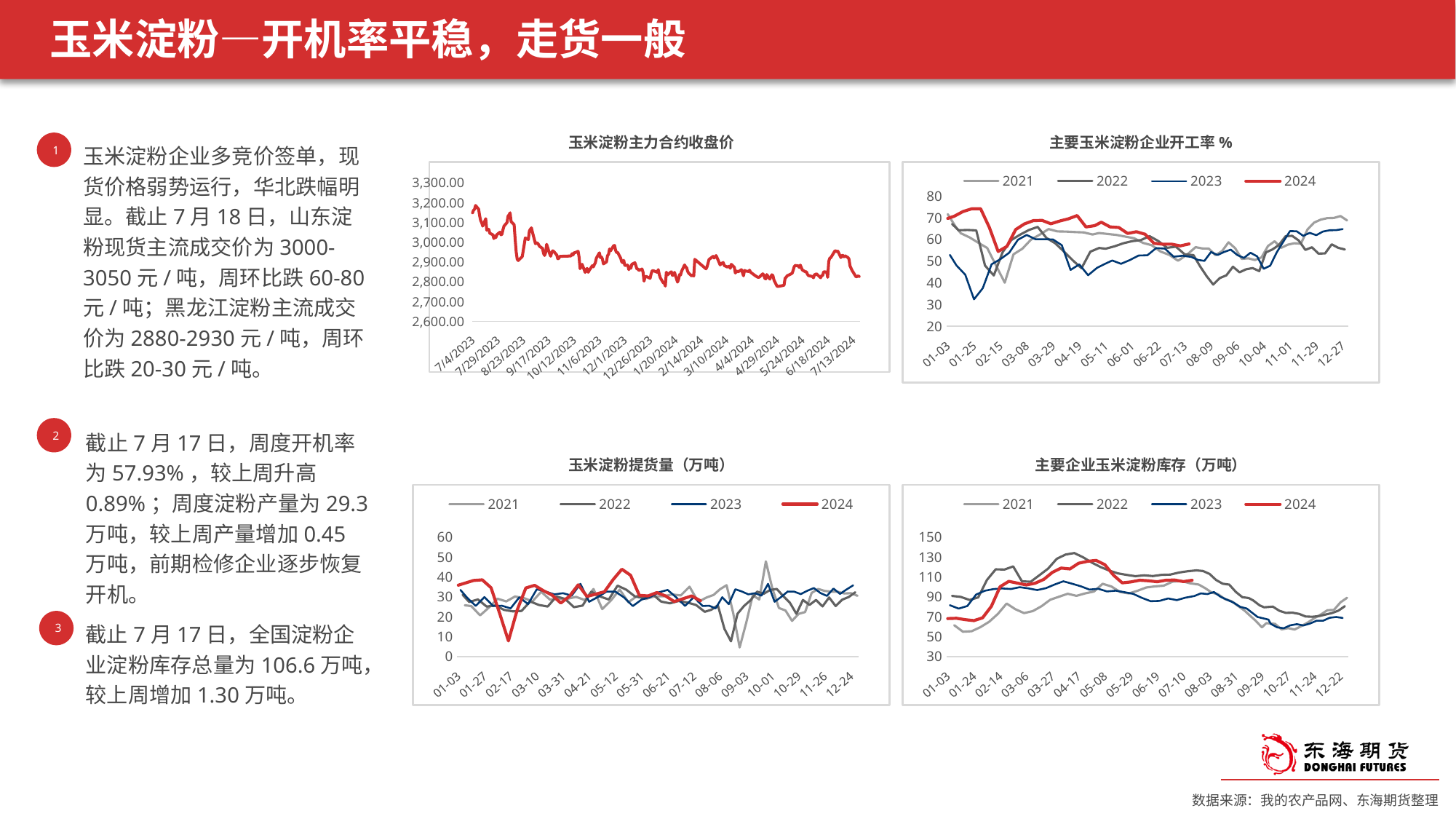
In the 玉米淀粉提货量（万吨） chart, is the 2021 value at 10-01 greater or less than 40? less What kind of chart is the 玉米淀粉主力合约收盘价 chart? line chart In the 主要企业玉米淀粉库存（万吨） chart, is the 2021 value at 01-03 greater or less than 70? less In the 玉米淀粉主力合约收盘价 chart, is the value at 7/4/2023 greater or less than 3,100.00? greater In the 玉米淀粉提货量（万吨） chart, which years are listed in the legend? 2021, 2022, 2023, 2024 In the 玉米淀粉主力合约收盘价 chart, do values overall rise or fall from 7/4/2023 to 7/13/2024? fall How many series does the legend of the 主要玉米淀粉企业开工率 % chart list? 4 In the 主要企业玉米淀粉库存（万吨） chart, which series is drawn in red? 2024